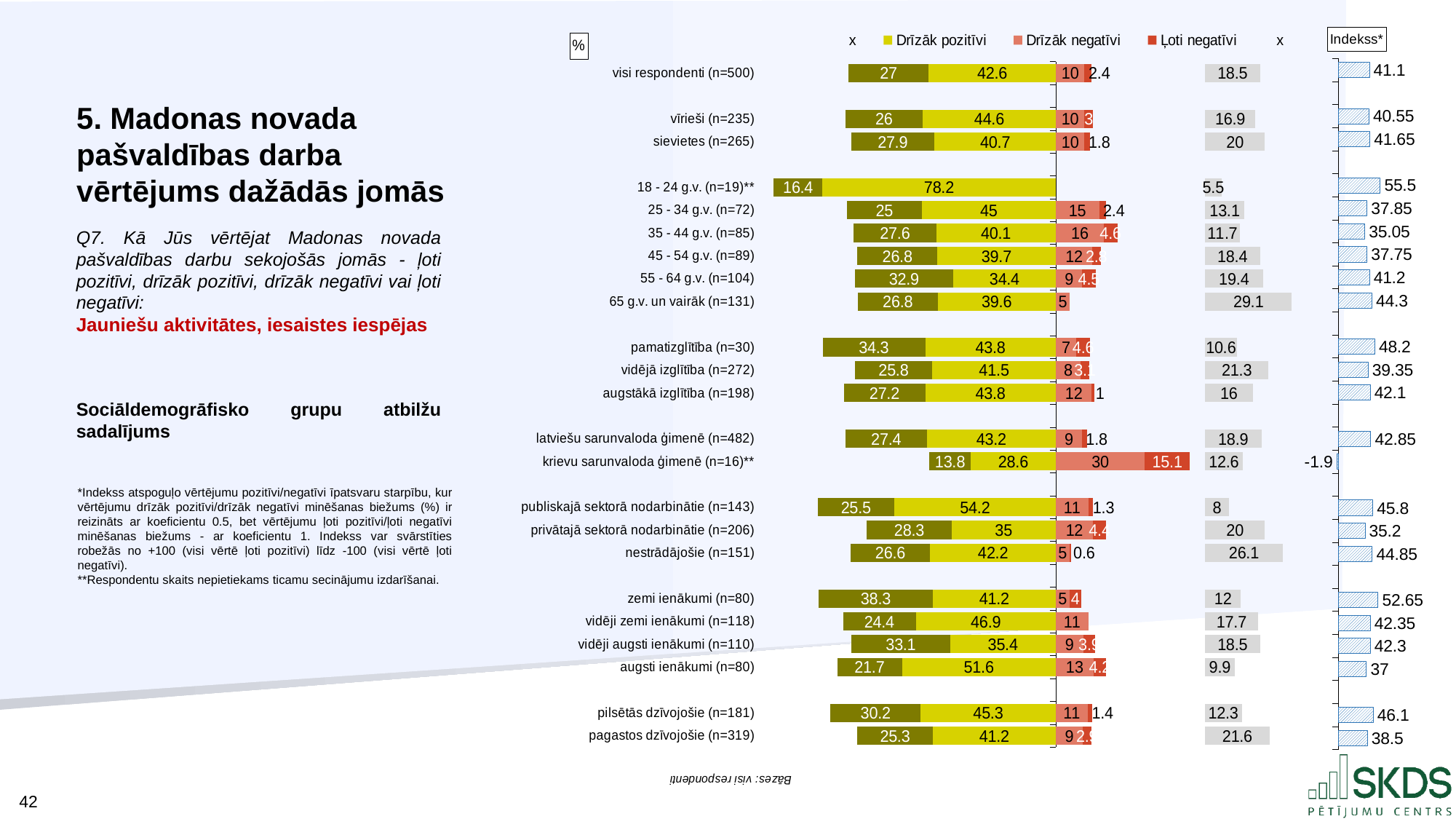
Which group has the highest Indekss value? 18 - 24 g.v. (n=19)** What is the Indekss value for 'zemi ienākumi (n=80)'? 52.65 What is the 'Drīzāk negatīvi' value for 'krievu sarunvaloda ģimenē (n=16)**'? 30 What kind of chart is shown on the slide? bar chart What is the 'Drīzāk pozitīvi' value for 'visi respondenti (n=500)'? 42.6 Which has a larger 'Drīzāk pozitīvi' value: 'publiskajā sektorā nodarbinātie (n=143)' or 'privātajā sektorā nodarbinātie (n=206)'? publiskajā sektorā nodarbinātie (n=143) What is the value in the grey column for '65 g.v. un vairāk (n=131)'? 29.1 What is the difference between the Indekss values for 'sievietes (n=265)' and 'vīrieši (n=235)'? 1.1 Which group has the lowest Indekss value? krievu sarunvaloda ģimenē (n=16)** How many series does the legend list? 3 What is the difference between the 'Drīzāk pozitīvi' values for '18 - 24 g.v. (n=19)**' and '25 - 34 g.v. (n=72)'? 33.2 What is the Indekss value for '18 - 24 g.v. (n=19)**'? 55.5